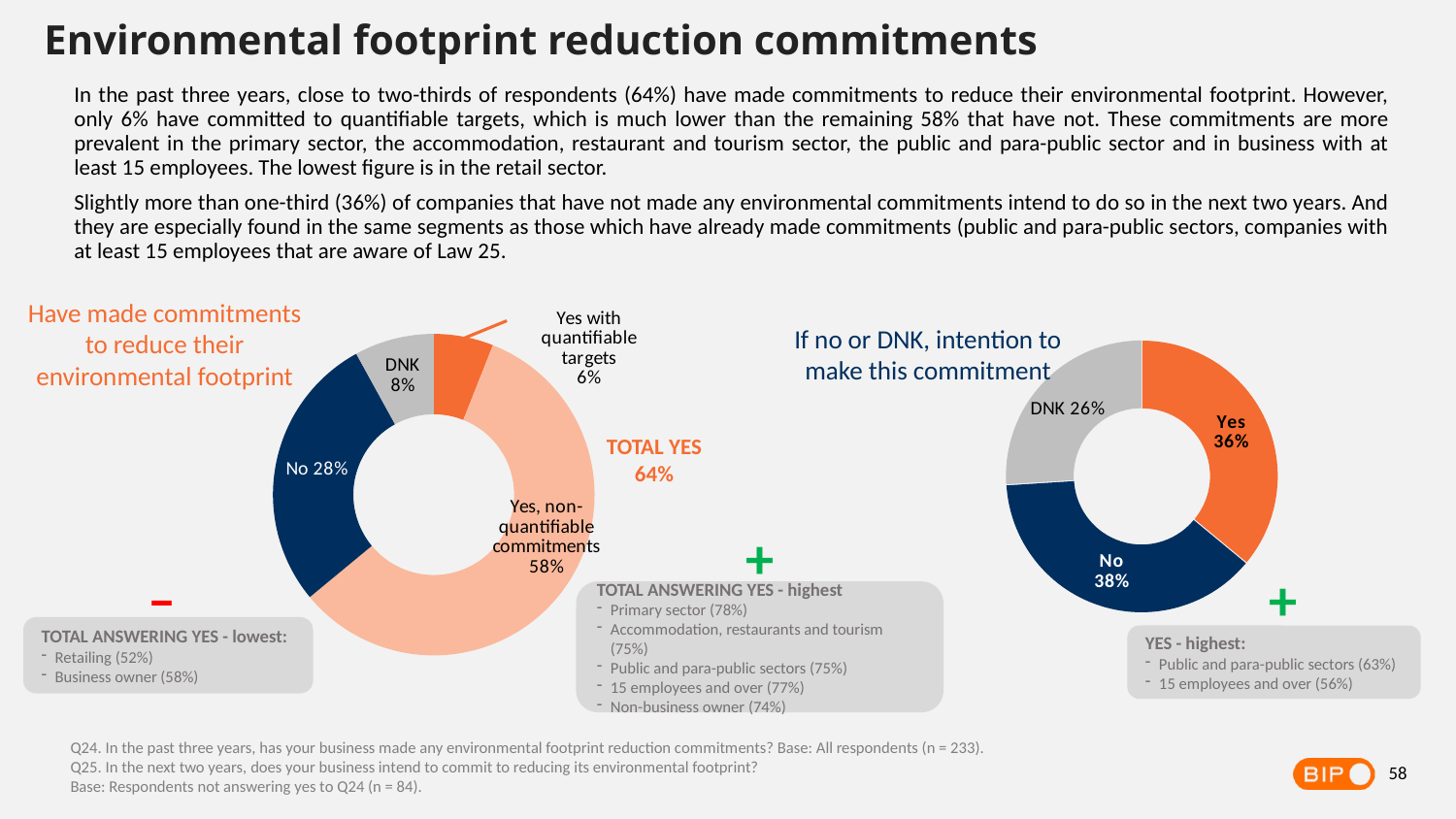
In the right chart 'If no or DNK, intention to make this commitment', what share answered 'DNK'? 26% What 'TOTAL YES' value is shown next to the left chart 'Have made commitments to reduce their environmental footprint'? 64% In the left chart 'Have made commitments to reduce their environmental footprint', what is the difference between the 'No' share and the 'DNK' share? 20 percentage points In the right chart 'If no or DNK, intention to make this commitment', what share answered 'Yes'? 36% In the right chart 'If no or DNK, intention to make this commitment', which category has the largest share? No What kind of chart is used for 'If no or DNK, intention to make this commitment'? Donut (pie) chart In the left chart 'Have made commitments to reduce their environmental footprint', which category has the smallest share? Yes with quantifiable targets In the left chart 'Have made commitments to reduce their environmental footprint', what share answered 'No'? 28% In the right chart 'If no or DNK, intention to make this commitment', what is the difference between the 'No' share and the 'Yes' share? 2 percentage points In the left chart 'Have made commitments to reduce their environmental footprint', what share answered 'Yes with quantifiable targets'? 6% In the left chart 'Have made commitments to reduce their environmental footprint', what share of respondents answered 'Yes, non-quantifiable commitments'? 58% In the left chart 'Have made commitments to reduce their environmental footprint', how many slices does the donut have? 4